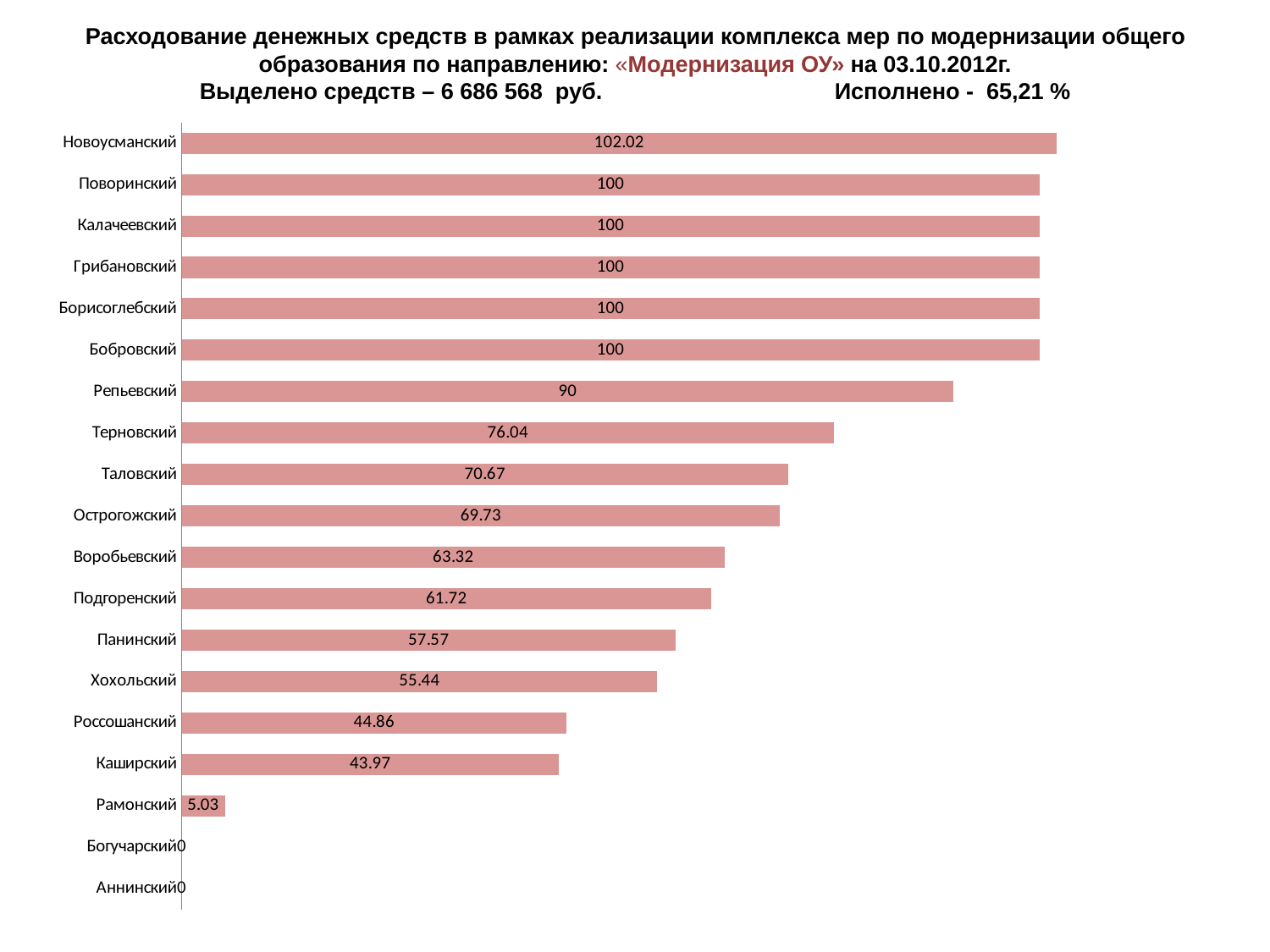
What is the value for Новоусманский? 102.02 What is the value for Терновский? 76.04 Which is larger, the value for Таловский or the value for Воробьевский? Таловский Which category has the highest value? Новоусманский What is the difference between the values for Репьевский and Терновский? 13.96 How many categories have a value of exactly 100? 5 What kind of chart is shown on the slide? bar chart What is the value for Каширский? 43.97 What is the difference between the values for Россошанский and Каширский? 0.89 How many categories have a value of 0? 2 How many categories are shown in the chart? 19 What is the value for Рамонский? 5.03